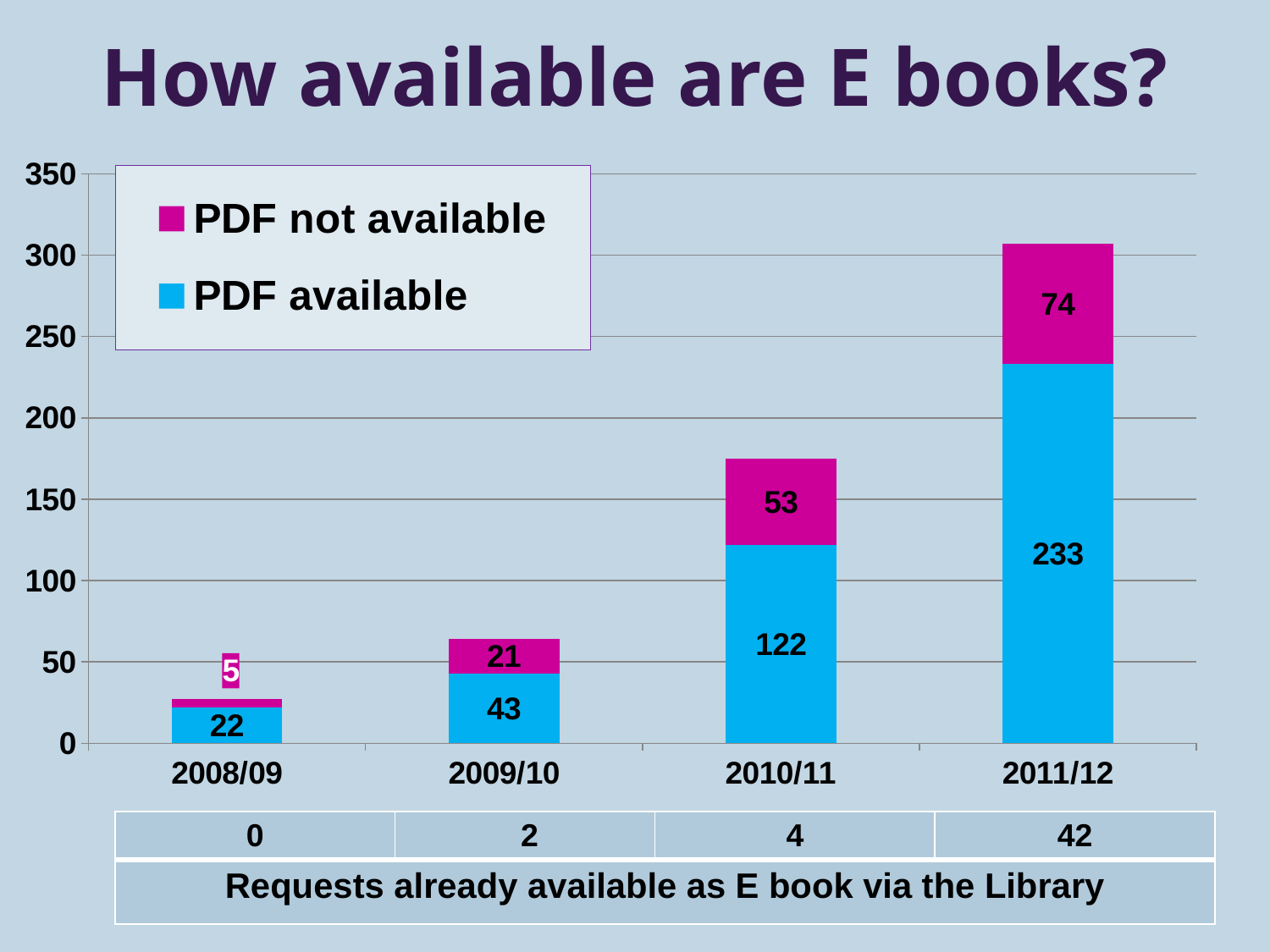
How many series does the legend list? 2 How many years are shown on the x axis? 4 What is the value for PDF available in 2011/12? 233 What is the value for PDF available in 2008/09? 22 What is the total of the stacked bar for 2009/10? 64 What is the total of the stacked bar for 2011/12? 307 Which year has the highest value for PDF not available? 2011/12 What is the difference between PDF available and PDF not available in 2010/11? 69 Does the value for PDF available rise or fall from 2008/09 to 2011/12? rise Which year has the lowest value for PDF available? 2008/09 What is the value for PDF not available in 2010/11? 53 Which is larger in 2009/10: PDF available or PDF not available? PDF available